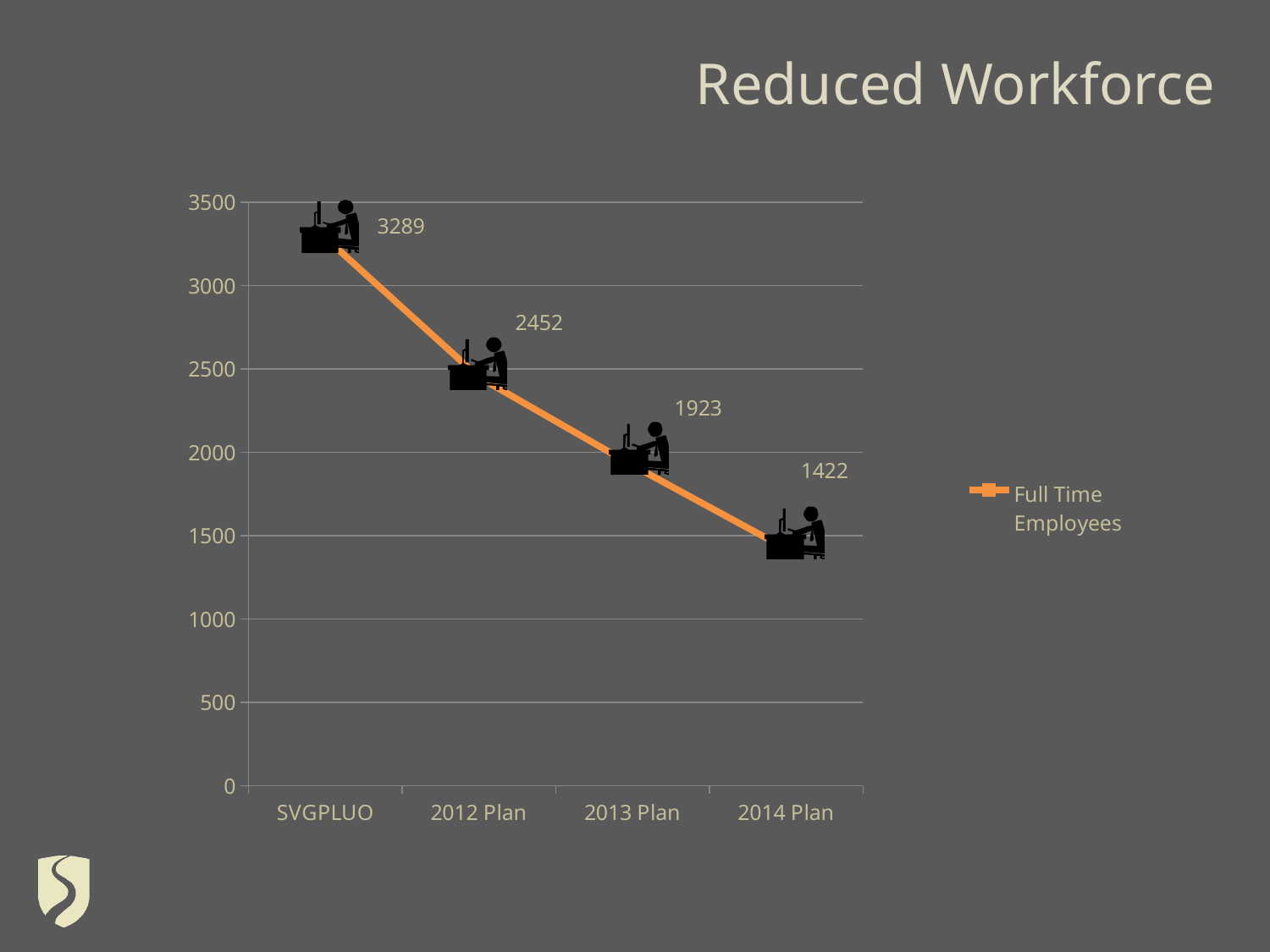
Which category has the highest value? SVGPLUO What kind of chart is shown on the slide? line chart What is the difference between the values for 2012 Plan and 2013 Plan? 529 What is the value for 2014 Plan? 1422 Do the values rise or fall from SVGPLUO to 2014 Plan? fall How many categories are shown on the x axis? 4 What is the value for 2012 Plan? 2452 What is the value for 2013 Plan? 1923 Which category has the lowest value? 2014 Plan What is the value for SVGPLUO? 3289 What is the difference between the values for SVGPLUO and 2014 Plan? 1867 Which is larger, the value for 2012 Plan or the value for 2013 Plan? 2012 Plan